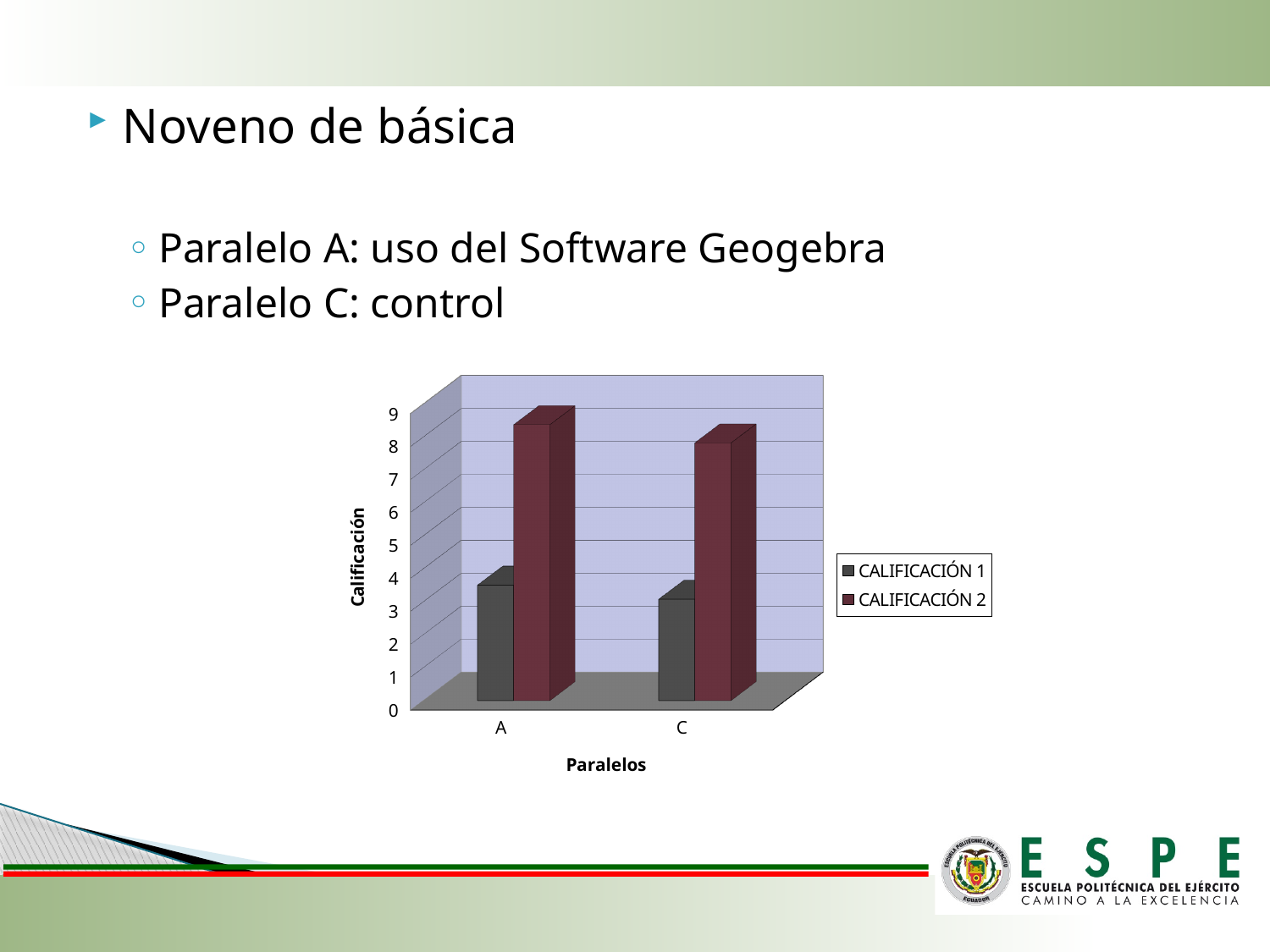
For CALIFICACIÓN 2, which paralelo has the larger value, A or C? A What is the title of the vertical axis? Calificación What is the title of the horizontal axis? Paralelos Is the CALIFICACIÓN 1 value for paralelo C greater or less than 4? less Is the CALIFICACIÓN 2 value for paralelo A greater or less than 7? greater For paralelo A, which is larger: CALIFICACIÓN 1 or CALIFICACIÓN 2? CALIFICACIÓN 2 Which category has the highest CALIFICACIÓN 2 bar? A Which category has the lowest CALIFICACIÓN 1 bar? C What kind of chart is shown on the slide? bar chart How many categories are shown on the x axis? 2 How many series does the legend list? 2 Is the CALIFICACIÓN 1 value for paralelo A greater or less than 5? less